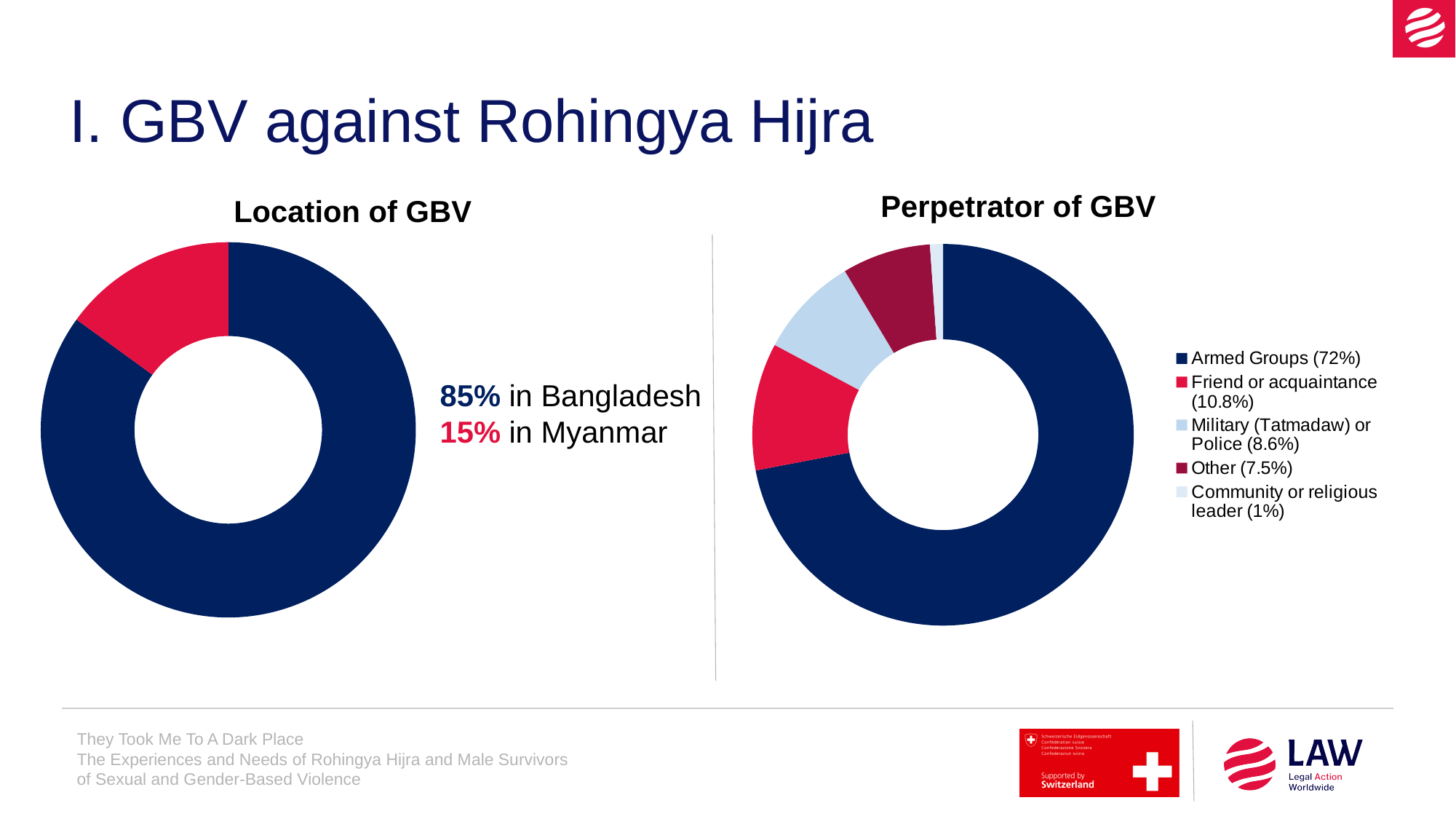
In the 'Location of GBV' chart, what share of GBV occurred in Myanmar? 15% In the 'Location of GBV' chart, what share of GBV occurred in Bangladesh? 85% What kind of chart is the 'Location of GBV' chart? Doughnut (pie) chart How many categories does the legend of the 'Perpetrator of GBV' chart list? 5 In the 'Location of GBV' chart, what is the difference between the Bangladesh and Myanmar shares? 70% In the 'Perpetrator of GBV' chart, what share is attributed to Friend or acquaintance? 10.8% In the 'Perpetrator of GBV' chart, what share is attributed to Armed Groups? 72% In the 'Perpetrator of GBV' chart, which is larger: Friend or acquaintance or Other? Friend or acquaintance In the 'Perpetrator of GBV' chart, which perpetrator category has the smallest share? Community or religious leader (1%) In the 'Perpetrator of GBV' chart, what share is attributed to Military (Tatmadaw) or Police? 8.6% In the 'Perpetrator of GBV' chart, which perpetrator category has the largest share? Armed Groups (72%) In the 'Perpetrator of GBV' chart, what is the difference between the Armed Groups share and the Friend or acquaintance share? 61.2%